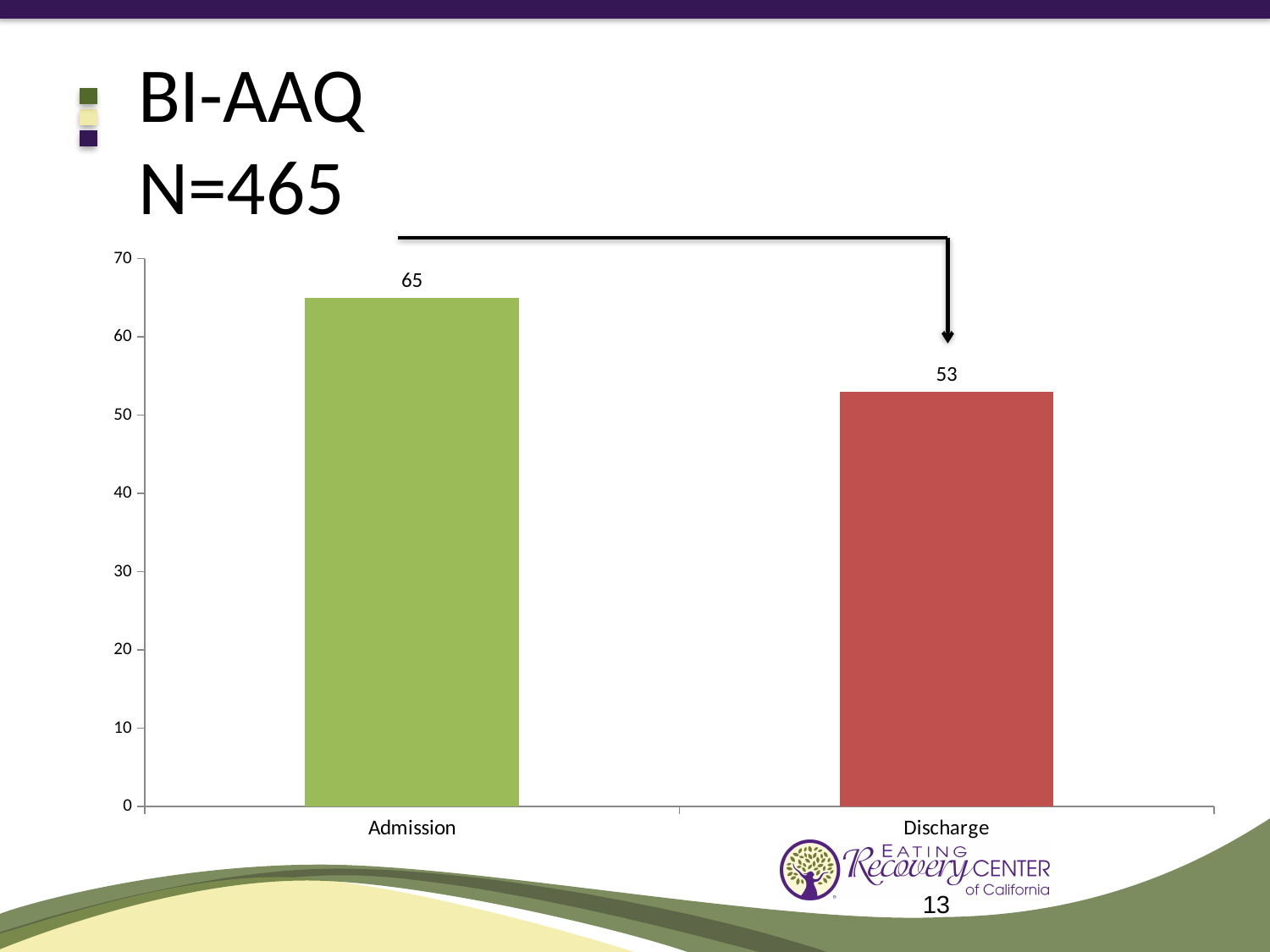
How many categories are shown on the x axis? 2 What is the difference between the Admission and Discharge values? 12 What is the value for Discharge? 53 What kind of chart is shown on the slide? bar chart What is the sample size (N) stated in the slide title? N=465 Is the value for Discharge greater or less than 60? less What is the value for Admission? 65 Is the value for Admission greater or less than 60? greater Which category has the lowest value? Discharge Do the values rise or fall from Admission to Discharge? fall Which category has the highest value? Admission Which is larger, the value for Admission or the value for Discharge? Admission